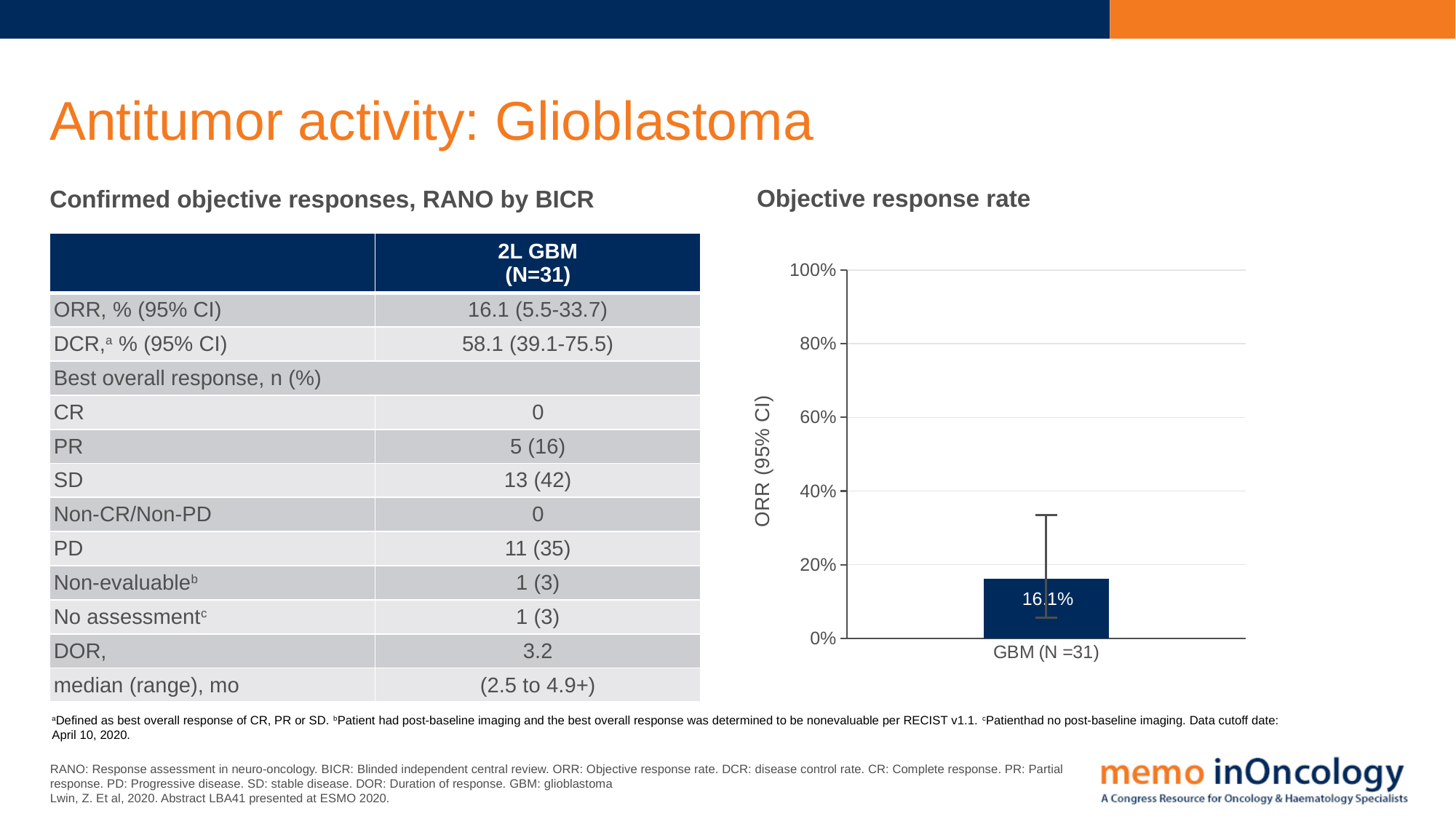
Is the value for GBM (N =31) in the Objective response rate chart greater or less than 40%? less What is the label of the y axis in the Objective response rate chart? ORR (95% CI) What is the value shown for GBM (N =31) in the Objective response rate chart? 16.1% Is the value for GBM (N =31) in the Objective response rate chart greater or less than 20%? less How many bars are plotted in the Objective response rate chart? 1 What is the title of the chart on the slide? Objective response rate What is the highest value shown on the y axis of the Objective response rate chart? 100% What kind of chart is used to show the objective response rate? bar chart